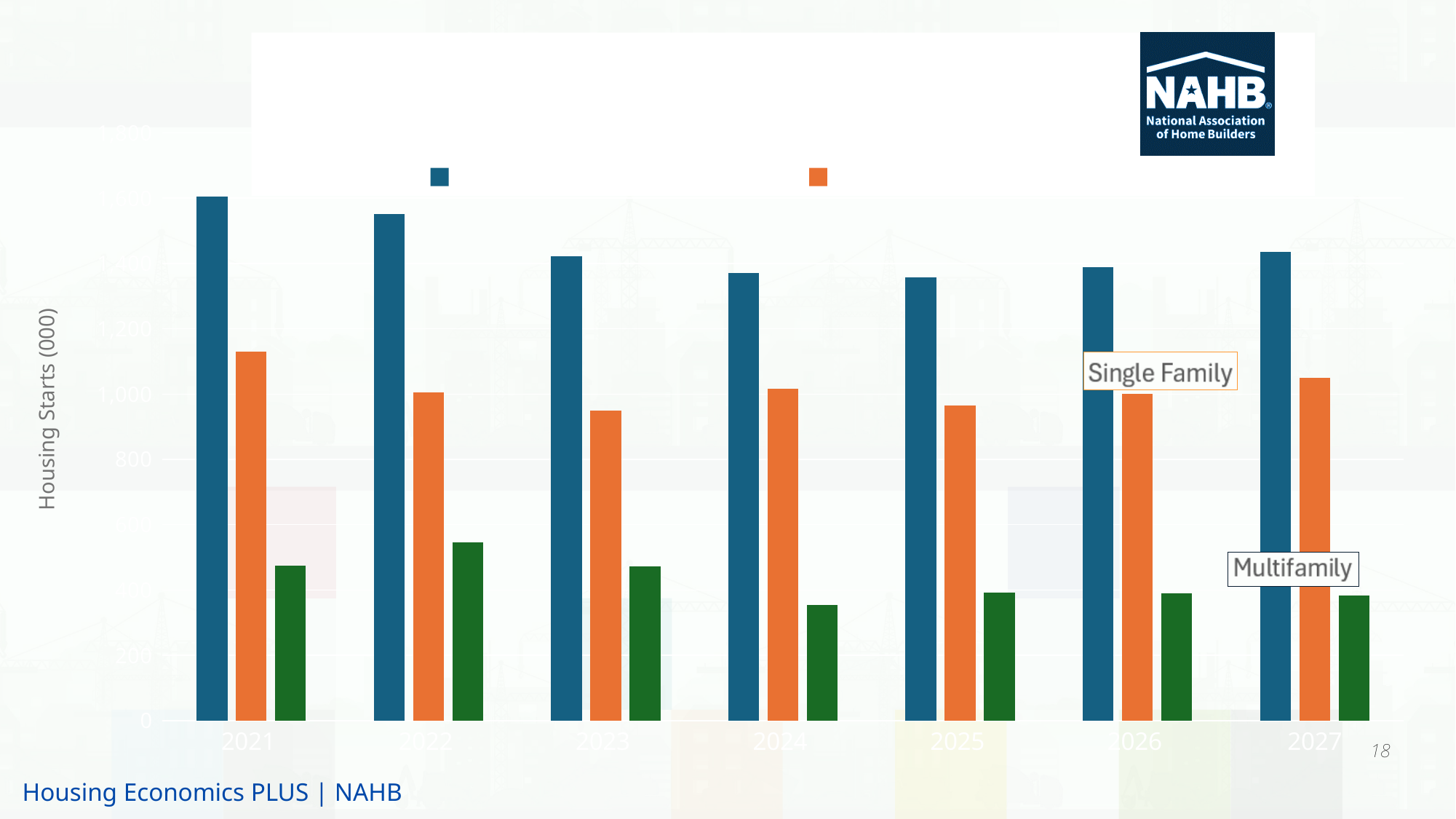
In which year is the Single Family bar the tallest? 2021 Is the Multifamily value for 2024 greater or less than 400? less What kind of chart is shown on the slide? bar chart Which is larger, the Single Family value for 2021 or for 2027? 2021 Is the Multifamily value for 2022 greater or less than 400? greater How many bars are plotted for each year in the chart? 3 What colour are the bars labelled "Multifamily"? green In which year is the Multifamily bar the tallest? 2022 How many years are shown on the x axis of the chart? 7 What is the title of the vertical axis? Housing Starts (000) In which year is the Multifamily bar the shortest? 2024 Is the Single Family value for 2021 greater or less than 1,000? greater